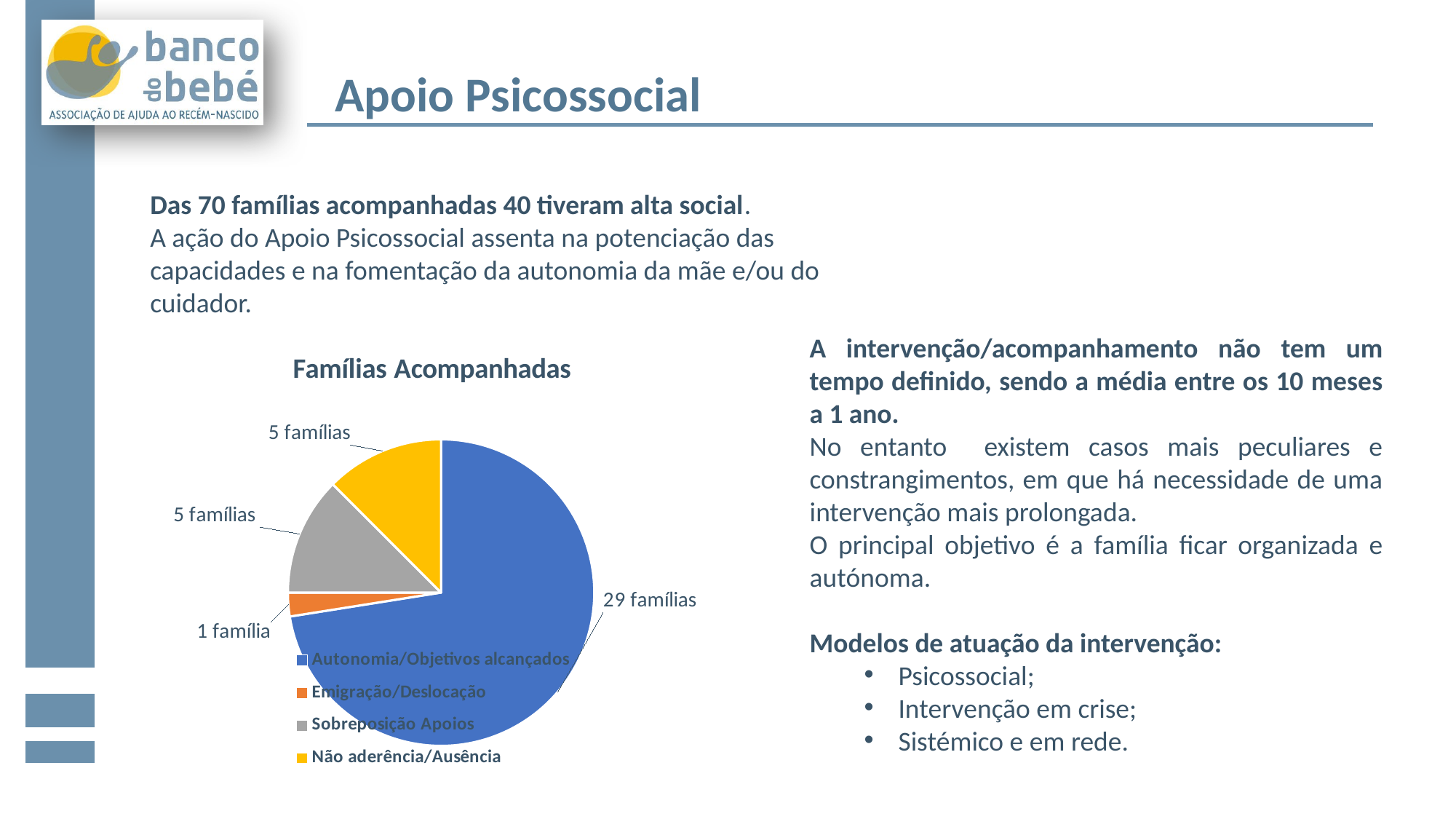
What is the total number of families across all slices of the pie chart? 40 What is the difference in families between "Autonomia/Objetivos alcançados" and "Sobreposição Apoios" in the pie chart? 24 Which category has the largest slice in the pie chart? Autonomia/Objetivos alcançados How many families are in the "Emigração/Deslocação" slice of the pie chart? 1 família Which has more families in the pie chart, "Sobreposição Apoios" or "Emigração/Deslocação"? Sobreposição Apoios How many families are in the "Sobreposição Apoios" slice of the pie chart? 5 famílias Which category has the smallest slice in the pie chart? Emigração/Deslocação How many families are in the "Autonomia/Objetivos alcançados" slice of the pie chart? 29 famílias How many categories does the legend of the pie chart list? 4 What type of chart is shown under the title "Famílias Acompanhadas"? Pie chart What is the title of the pie chart? Famílias Acompanhadas How many families are in the "Não aderência/Ausência" slice of the pie chart? 5 famílias